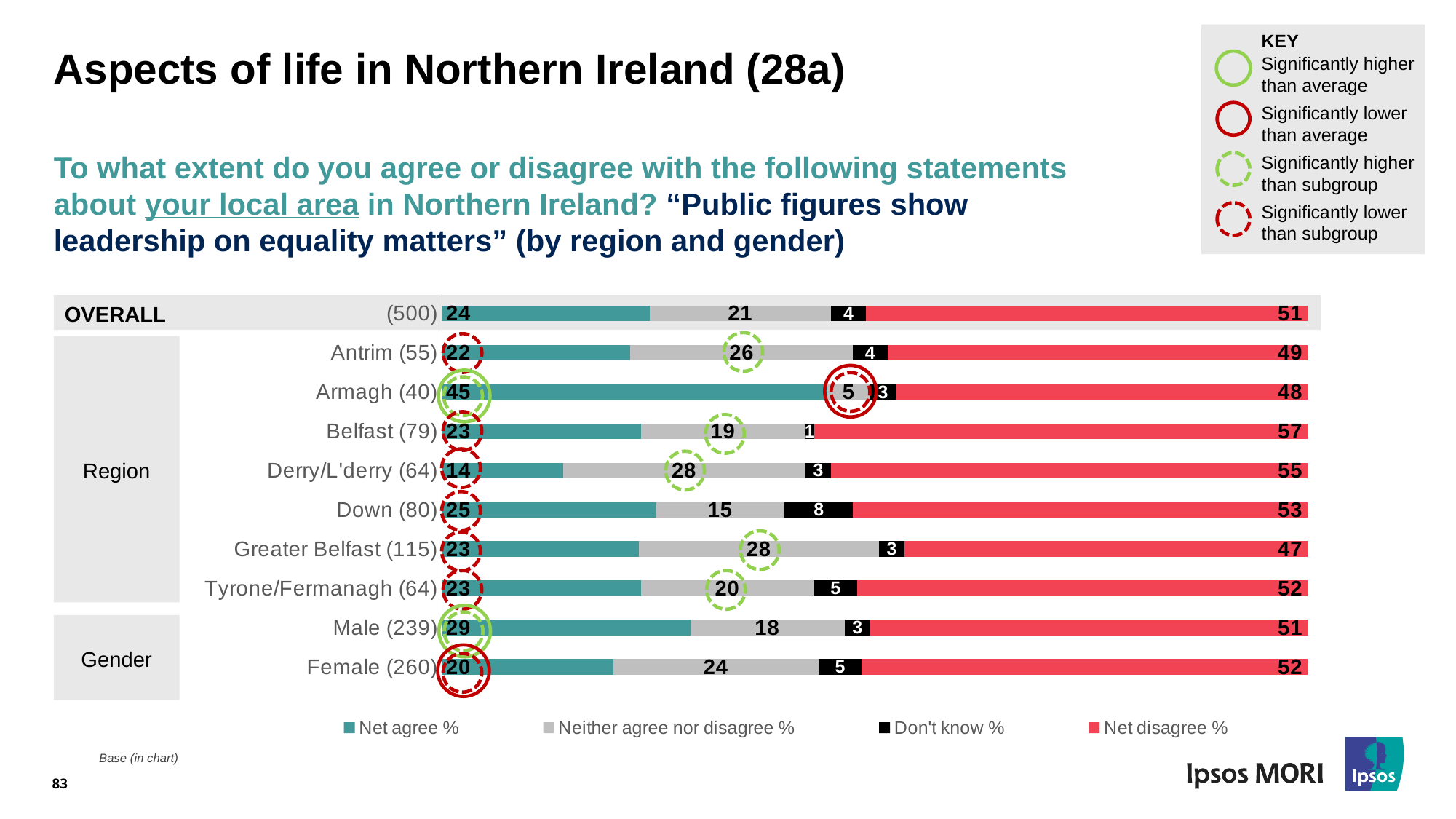
What is the Don't know % for Down (80)? 8 What kind of chart is shown on the slide? Stacked bar chart Which group has the lowest Net agree %? Derry/L'derry (64) How many series does the legend list? 4 What is the Net agree % for Armagh (40)? 45 How many groups (bars) are shown in the chart, including OVERALL? 10 Which group has the highest Net agree %? Armagh (40) Which group has the highest Net disagree %? Belfast (79) What is the Neither agree nor disagree % for Derry/L'derry (64)? 28 What is the Net disagree % for Belfast (79)? 57 What is the difference in Net agree % between Male (239) and Female (260)? 9 Which has a higher Net disagree %, Antrim (55) or Greater Belfast (115)? Antrim (55)